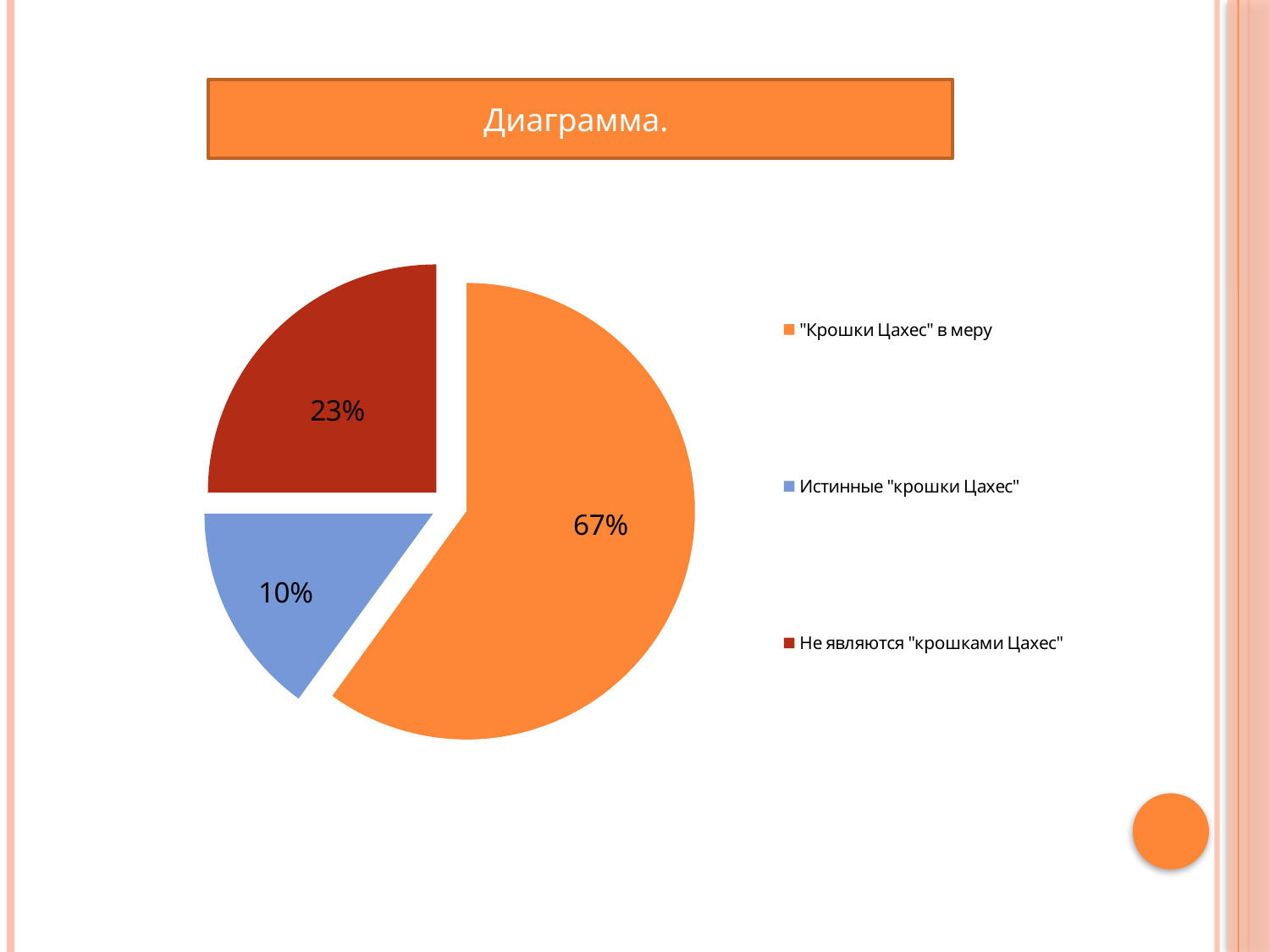
What kind of chart is shown on the slide? pie chart What share of the pie does Истинные "крошки Цахес" have? 10% Which category has the largest slice of the pie? "Крошки Цахес" в меру What share of the pie does Не являются "крошками Цахес" have? 23% How many slices does the pie chart have? 3 Which category has the smallest slice of the pie? Истинные "крошки Цахес" What colour is the slice for Истинные "крошки Цахес"? blue Which is larger: the slice for Истинные "крошки Цахес" or the slice for Не являются "крошками Цахес"? Не являются "крошками Цахес" What is the difference in percentage points between the Не являются "крошками Цахес" slice and the Истинные "крошки Цахес" slice? 13 What share of the pie does "Крошки Цахес" в меру have? 67% What is the difference in percentage points between the "Крошки Цахес" в меру slice and the Не являются "крошками Цахес" slice? 44 What is the title shown above the chart? Диаграмма.